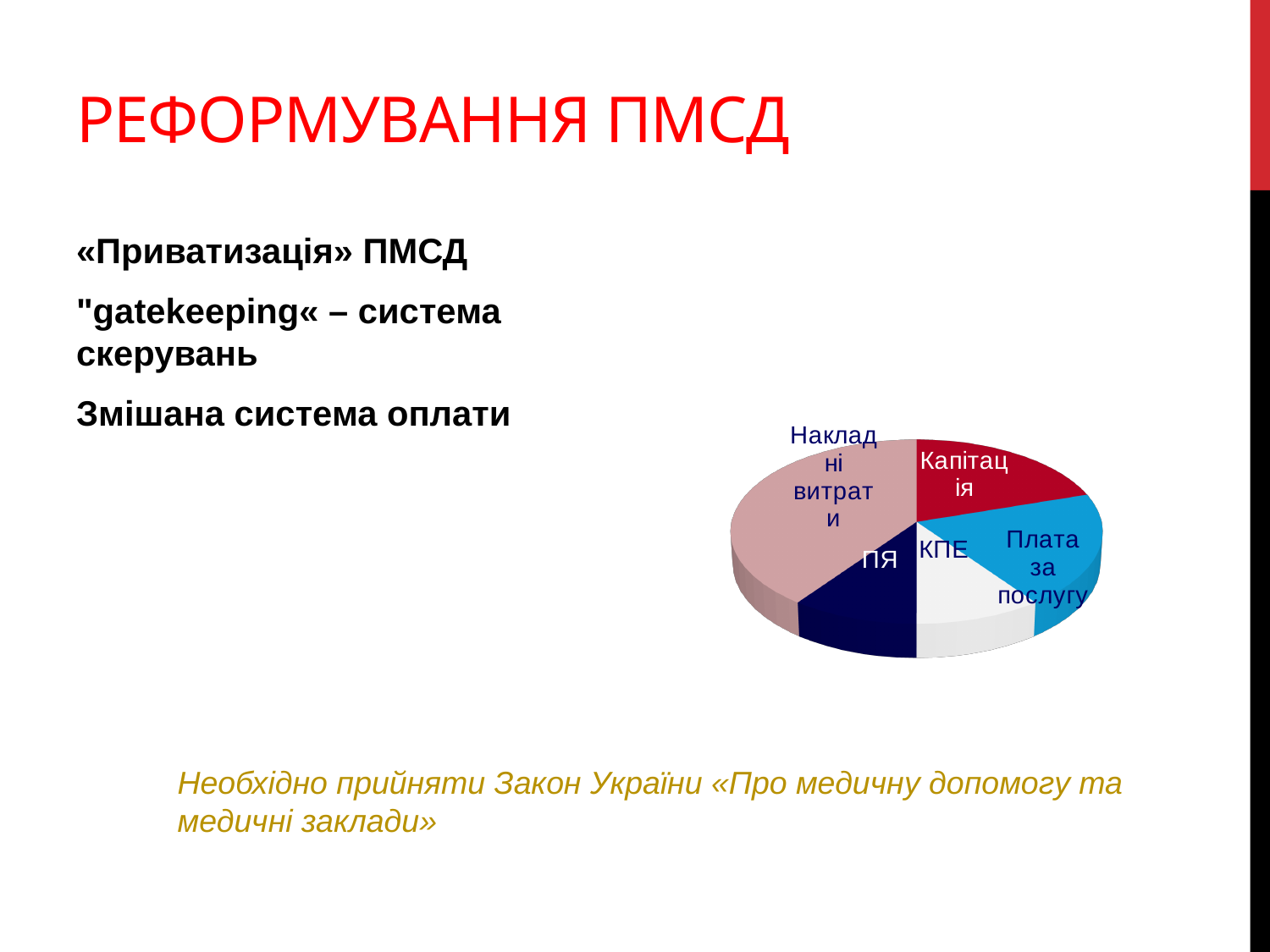
How many slices does the pie chart have? 5 What kind of chart is shown on the slide? pie chart What colour is the Накладні витрати slice in the pie chart? pink Which slice of the pie chart is the largest? Накладні витрати Which slice is larger in the pie chart, Накладні витрати or Плата за послугу? Накладні витрати What colour is the Капітація slice in the pie chart? red Which slice is larger in the pie chart, Накладні витрати or КПЕ? Накладні витрати Which slice is larger in the pie chart, Накладні витрати or Капітація? Накладні витрати